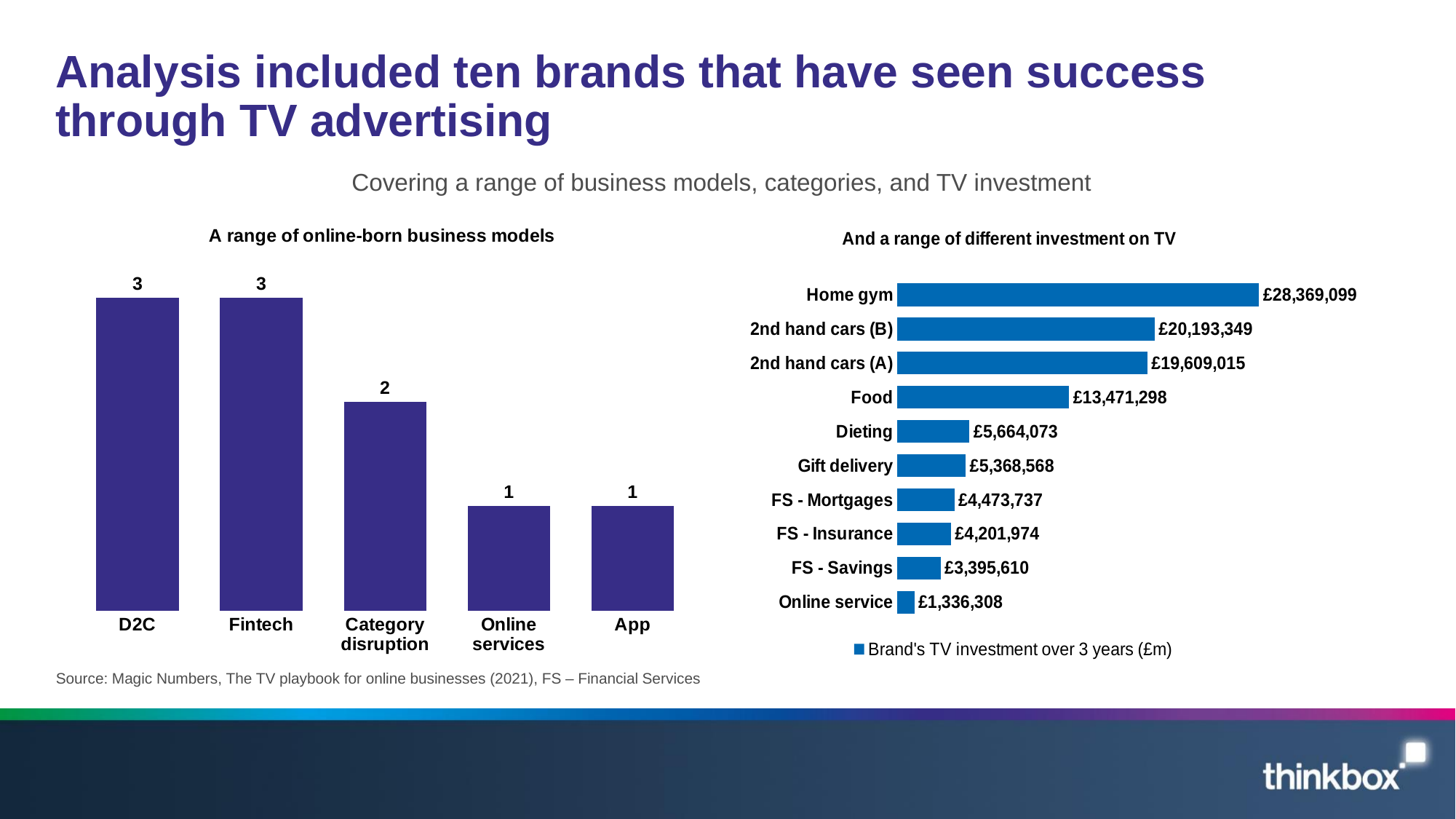
In the chart 'And a range of different investment on TV', what is the value for Food? £13,471,298 In the chart 'A range of online-born business models', how many categories are shown on the x axis? 5 In the chart 'A range of online-born business models', which of Fintech or Online services has the larger value? Fintech In the chart 'And a range of different investment on TV', which category has the lowest value? Online service In the chart 'And a range of different investment on TV', what is the difference between the values for 2nd hand cars (B) and 2nd hand cars (A)? £584,334 In the chart 'And a range of different investment on TV', what is the legend entry? Brand's TV investment over 3 years (£m) In the chart 'And a range of different investment on TV', what is the value for FS - Insurance? £4,201,974 In the chart 'And a range of different investment on TV', how many categories are shown? 10 In the chart 'And a range of different investment on TV', which category has the highest value? Home gym In the chart 'A range of online-born business models', what is the difference between the values for D2C and App? 2 In the chart 'A range of online-born business models', what is the value for Category disruption? 2 What kind of chart is 'A range of online-born business models'? Bar chart